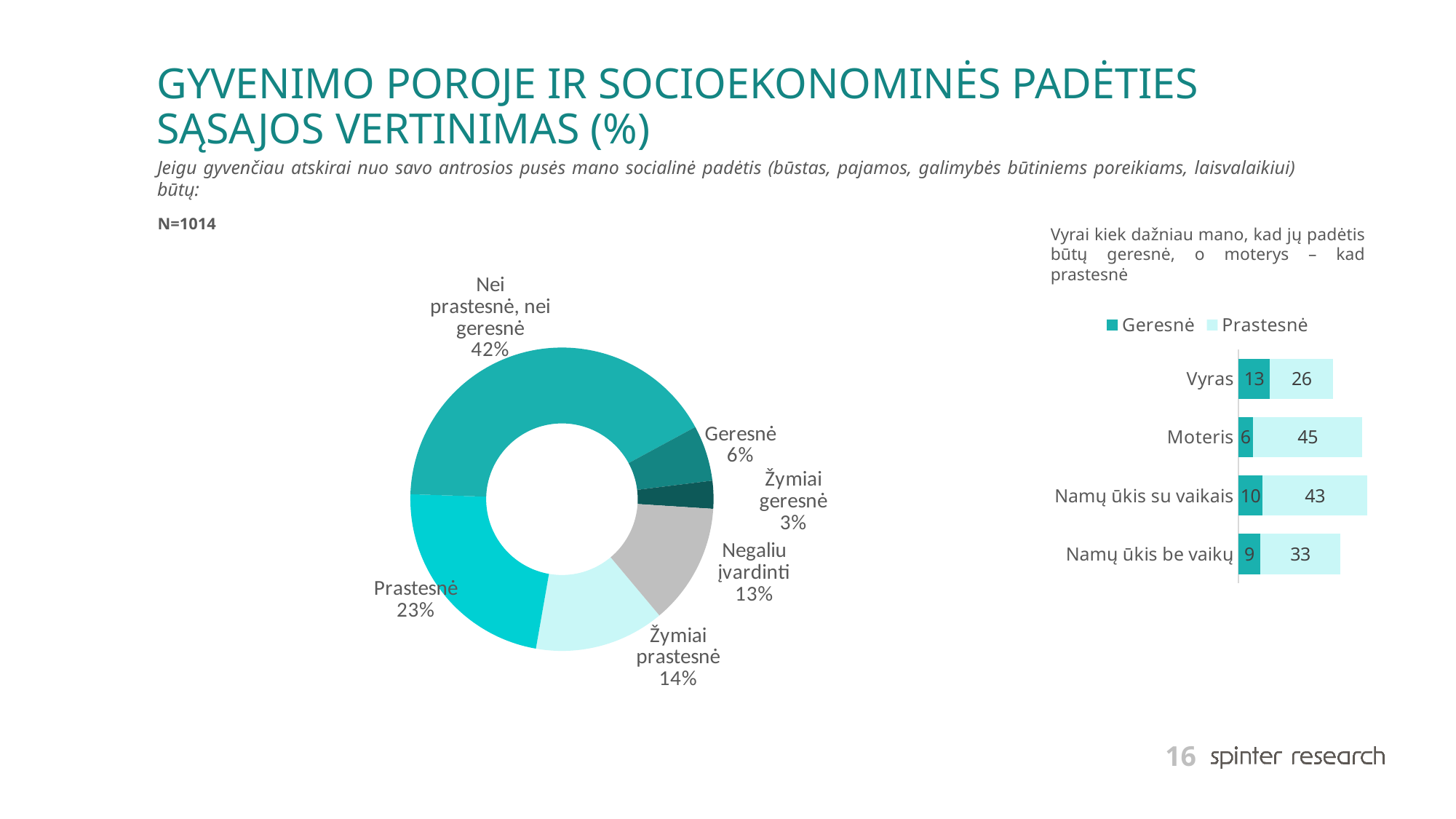
In the bar chart on the right, what is the 'Prastesnė' value for 'Moteris'? 45 In the bar chart on the right, how many series does the legend list? 2 In the donut chart on the left, which category has the largest share? Nei prastesnė, nei geresnė In the bar chart on the right, what is the 'Geresnė' value for 'Vyras'? 13 In the donut chart on the left, which category has the smallest share? Žymiai geresnė In the donut chart on the left, what share is labelled 'Prastesnė'? 23% In the donut chart on the left, how many categories are shown? 6 What type of chart is shown on the right side of the slide? Stacked bar chart In the bar chart on the right, what is the total of the stacked bar for 'Namų ūkis su vaikais'? 53 In the donut chart on the left, what is the difference between the 'Prastesnė' and 'Geresnė' shares? 17% In the bar chart on the right, which group has the highest 'Prastesnė' value? Moteris In the donut chart on the left, what share is labelled 'Nei prastesnė, nei geresnė'? 42%